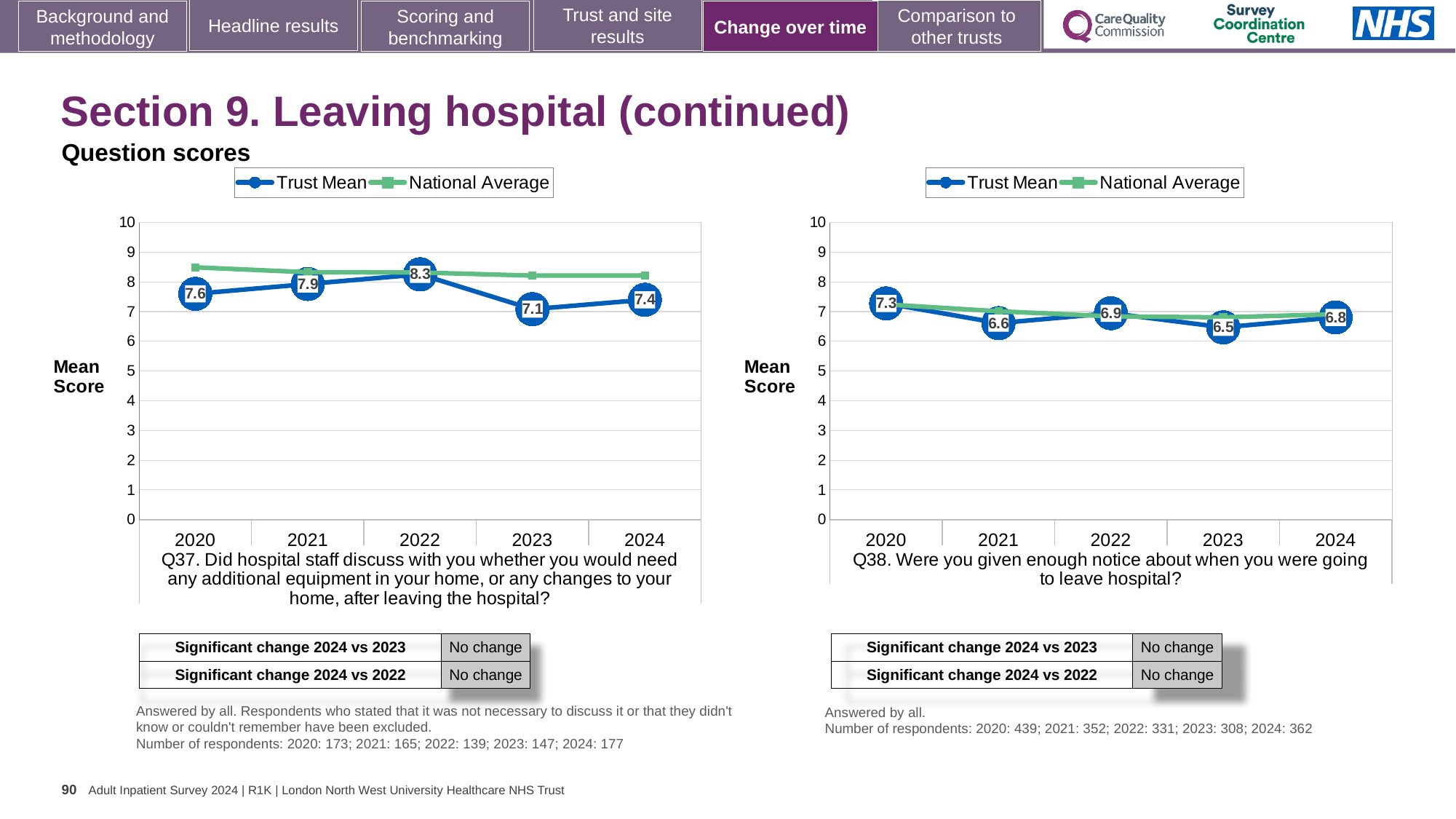
On the Q38 chart (right), which year has the lowest Trust Mean score? 2023 What type of chart is the Q38 chart (right)? Line chart On the Q37 chart (left), what is the difference between the Trust Mean scores for 2022 and 2023? 1.2 On the Q38 chart (right), is the Trust Mean score for 2021 or 2022 larger? 2022 On the Q38 chart (right), what is the Trust Mean score for 2020? 7.3 How many series does the legend of the Q37 chart (left) list? 2 How many years are plotted on the Q38 chart (right)? 5 On the Q37 chart (left), which year has the highest Trust Mean score? 2022 On the Q37 chart (left), what is the Trust Mean score for 2023? 7.1 On the Q38 chart (right), what is the Trust Mean score for 2024? 6.8 On the Q37 chart (left), is the National Average for 2020 greater or less than 8? greater On the Q37 chart (left), what is the Trust Mean score for 2022? 8.3